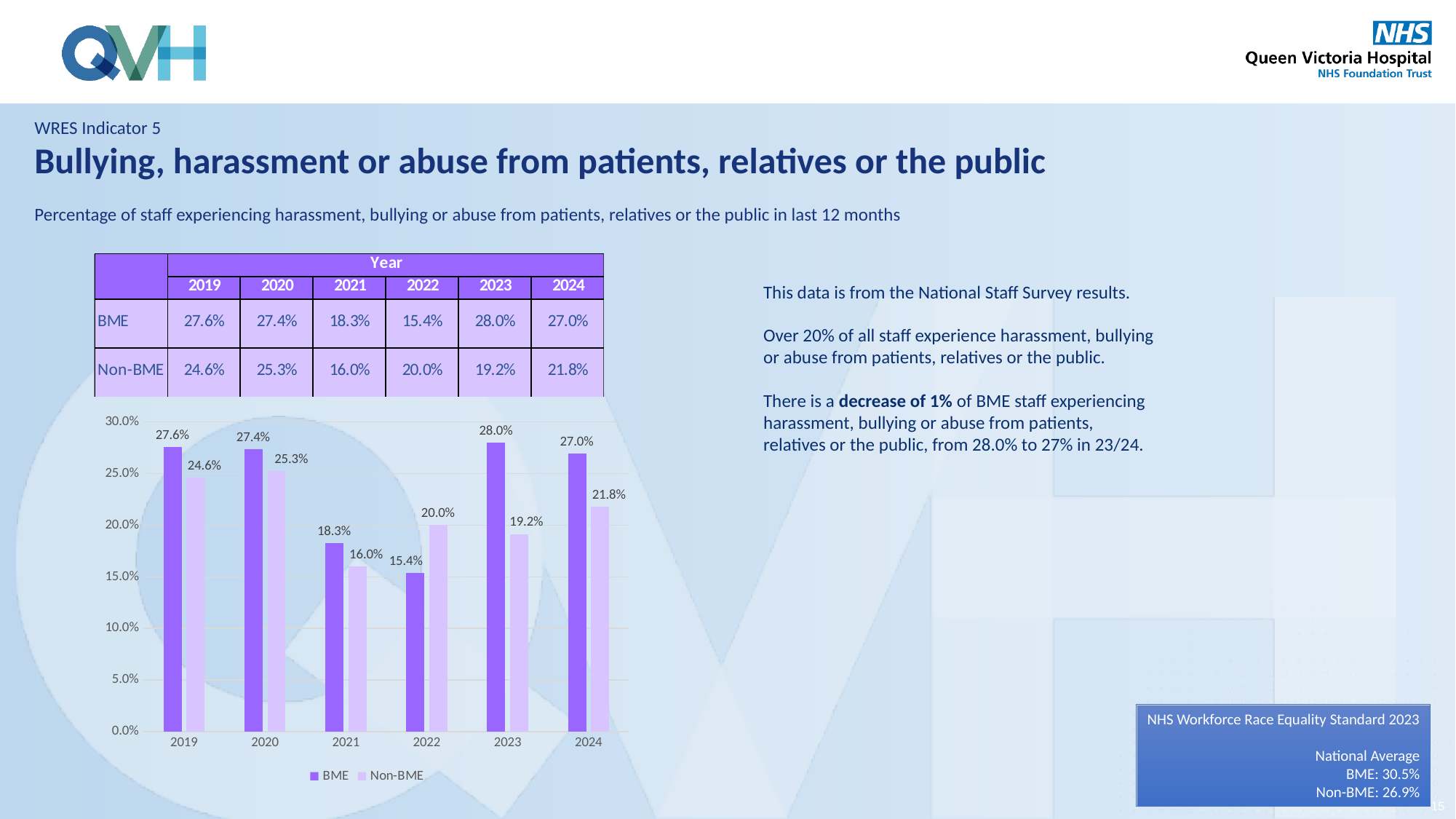
What is the BME value for 2021? 18.3% Did the BME value rise or fall from 2023 to 2024? Fall Which year has the lowest Non-BME value? 2021 What are the two series named in the chart legend? BME and Non-BME What is the BME value for 2023? 28.0% What kind of chart is shown on the slide? Bar chart What is the Non-BME value for 2022? 20.0% How many series does the chart legend list? 2 Which is larger in 2022, the BME value or the Non-BME value? Non-BME How many years are shown on the x axis of the chart? 6 What is the difference between the BME and Non-BME values in 2023? 8.8% Which year has the highest BME value? 2023